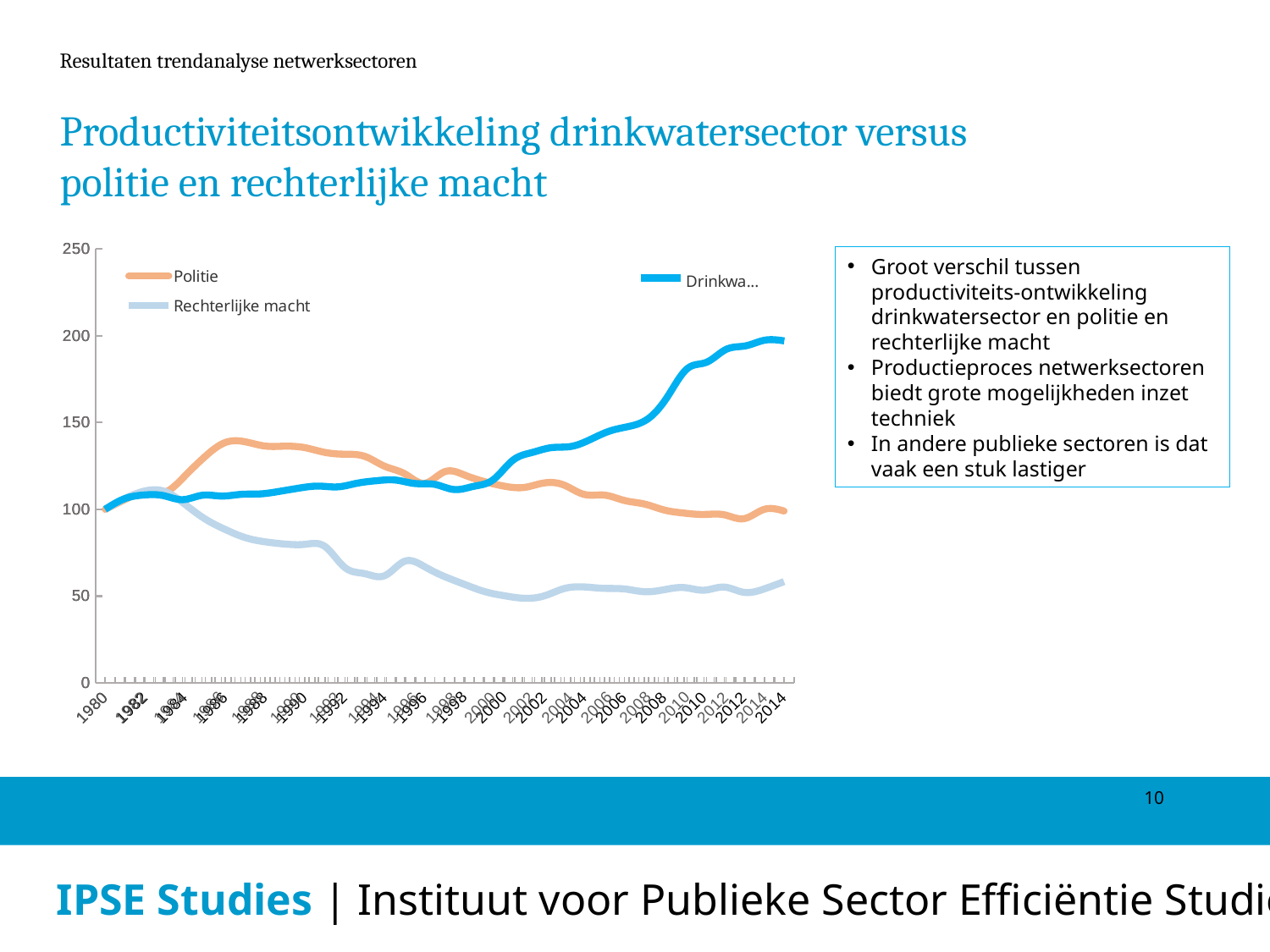
Is the value of the Drinkwa… (drinkwater) series in 2014 greater or less than 150? greater What colour is the Politie line in the chart? orange What kind of chart is shown on the slide? line chart In 2014, which is larger: the Politie series or the Drinkwa… (drinkwater) series? Drinkwa… (drinkwater) Which series has the highest value in 2014? Drinkwa… (drinkwater) Is the value of the Politie series in 2014 greater or less than 150? less How many series does the chart's legend list? 3 Does the Rechterlijke macht series rise or fall from 1980 to 2014? fall Is the value of the Rechterlijke macht series in 2014 greater or less than 100? less Does the Drinkwa… (drinkwater) series rise or fall from 1980 to 2014? rise What is the value of the Politie series in 1980? 100 Which series has the lowest value in 2014? Rechterlijke macht